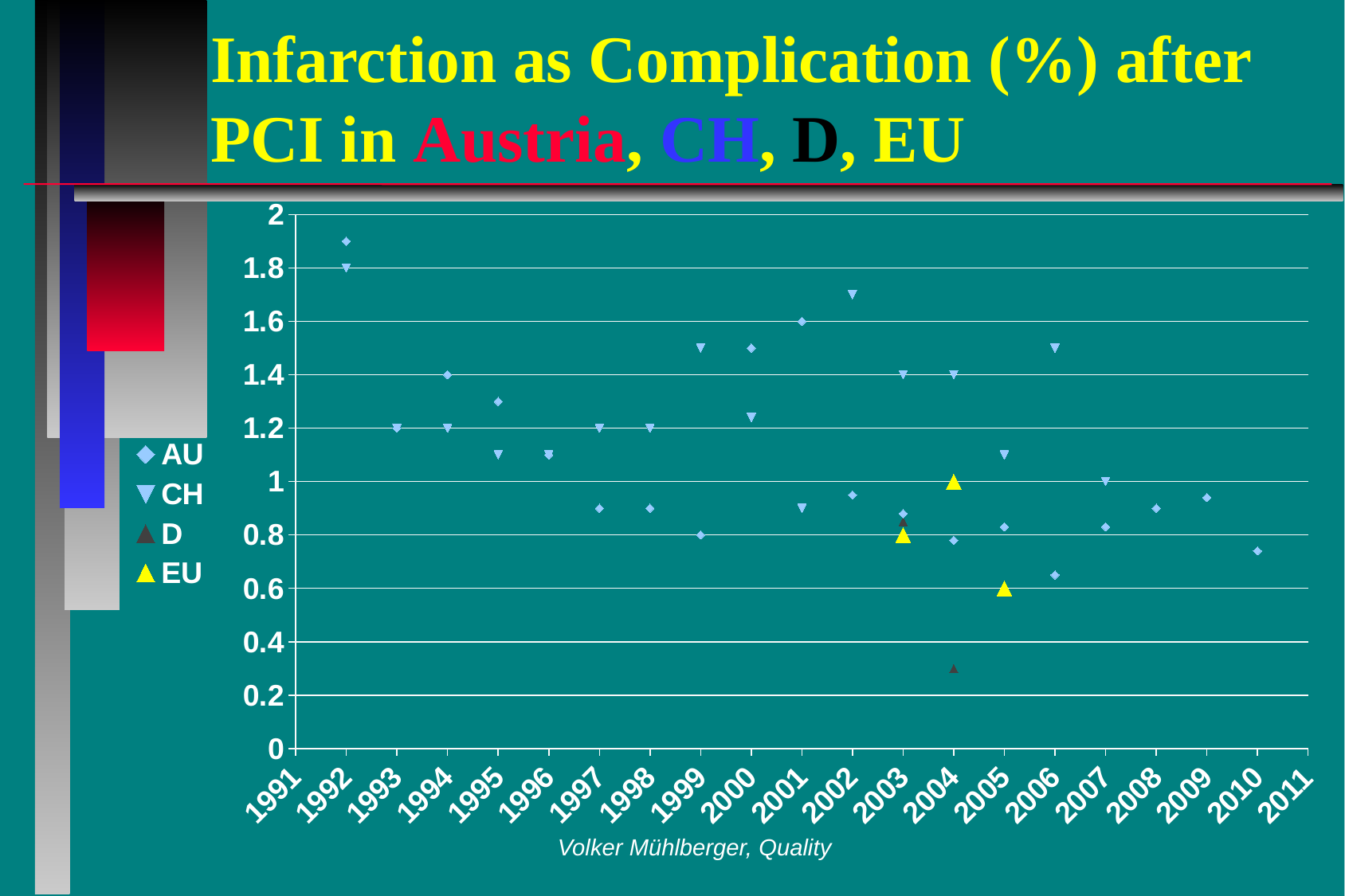
Is the D value for 2004 greater or less than 0.4? less Is the AU value for 2006 greater or less than 0.8? less Do the AU values generally rise or fall from 1992 to 2010? fall What kind of chart is shown on the slide? scatter chart How many series does the legend list? 4 Is the AU value for 1992 greater or less than 1.6? greater Which series has the lowest plotted value on the chart? D How many data points are plotted for the EU series? 3 How many data points are plotted for the D series? 2 Which series are listed in the legend? AU, CH, D, EU